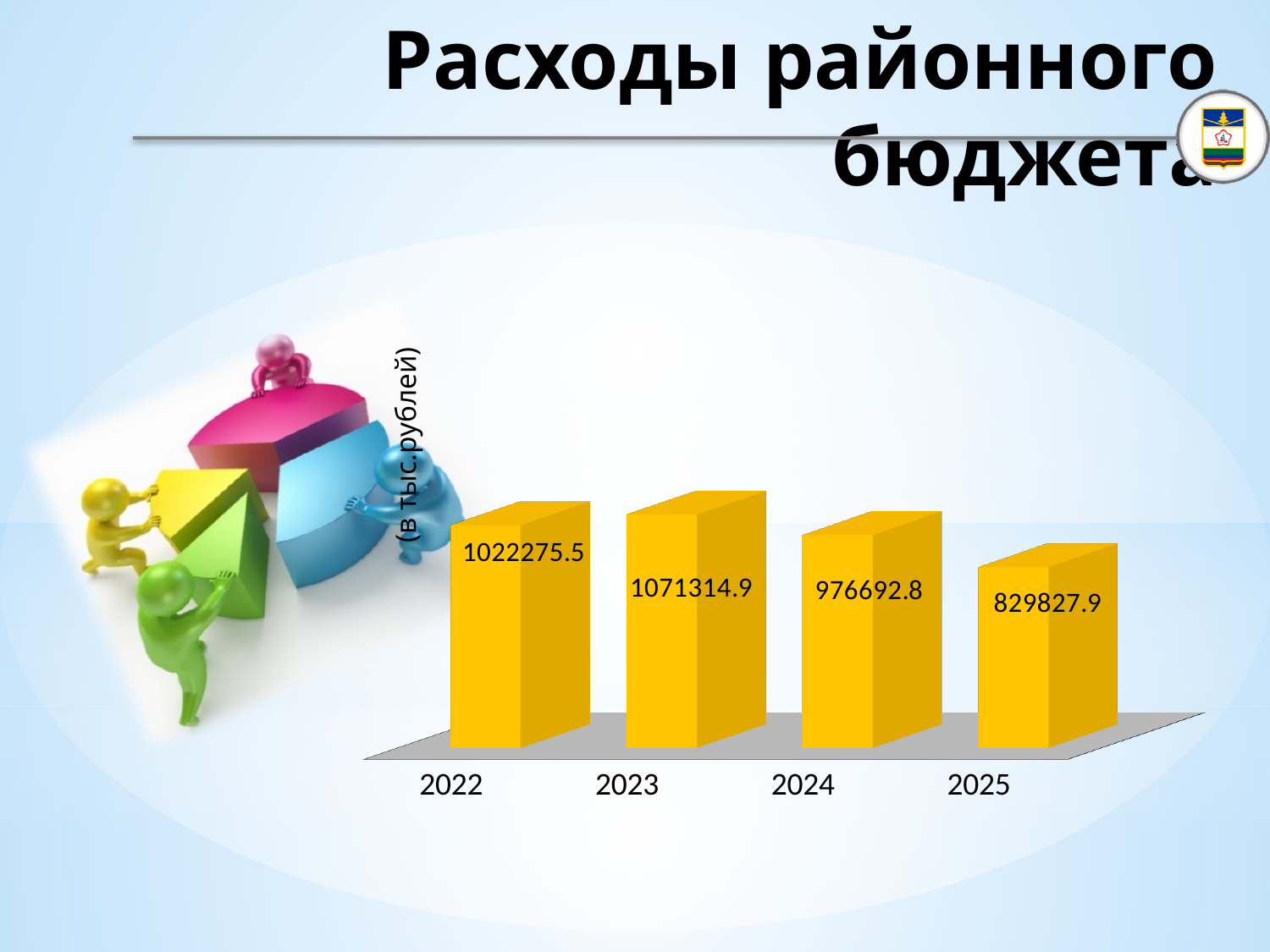
What is the value shown for 2023? 1071314.9 What is the value shown for 2022? 1022275.5 Which is larger, the value for 2024 or the value for 2025? 2024 What kind of chart is shown on the slide? Bar chart Which year has the lowest value? 2025 What is the value shown for 2025? 829827.9 How many years are shown on the chart? 4 What is the difference between the values for 2024 and 2025? 146864.9 According to the data labels, which year has the highest value? 2023 Do the values rise or fall from 2023 to 2025? Fall What is the difference between the values for 2023 and 2022? 49039.4 What is the value shown for 2024? 976692.8